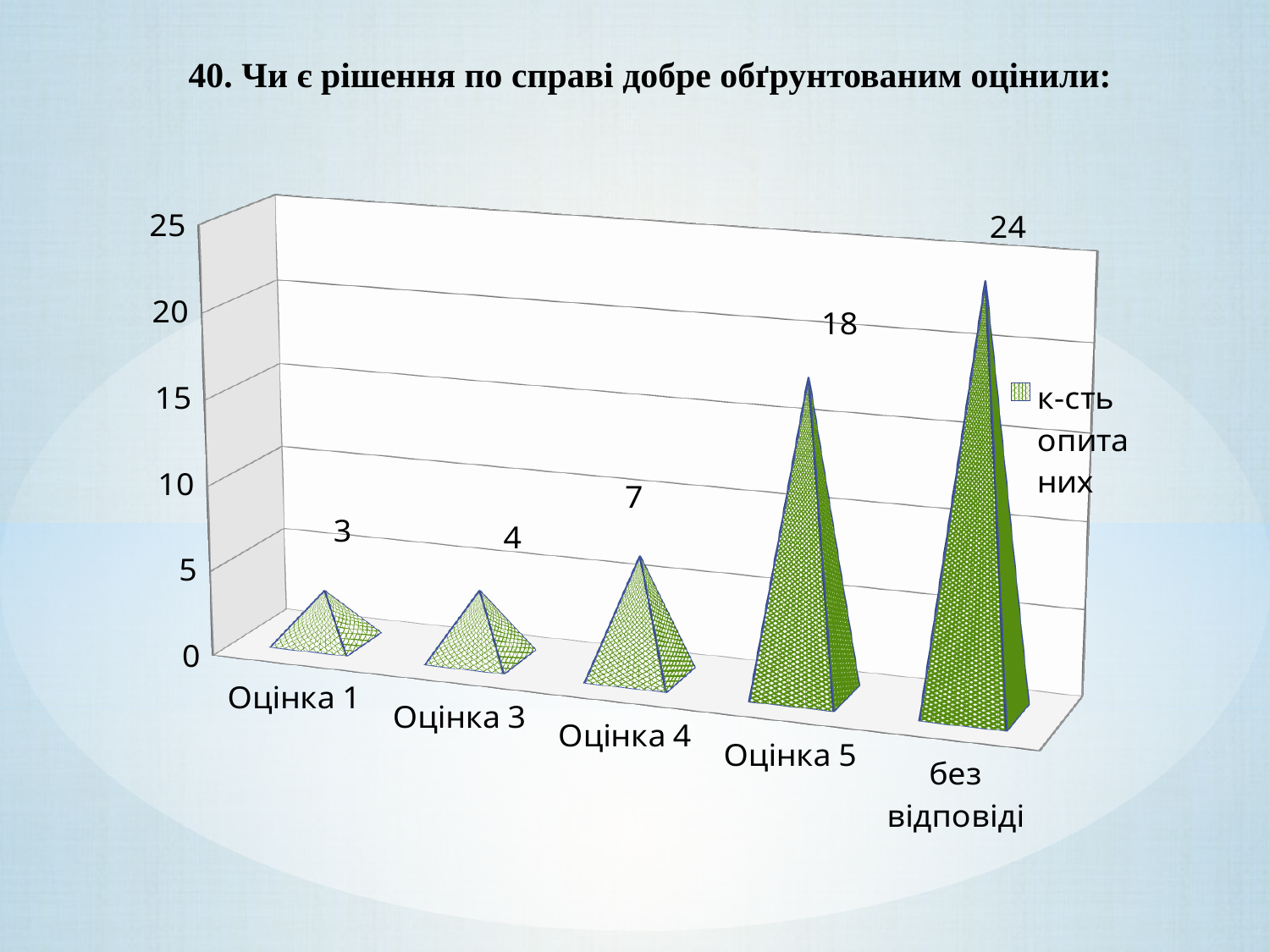
What is the difference between the values for без відповіді and Оцінка 5? 6 Which category has the lowest value? Оцінка 1 What is the value for Оцінка 5? 18 Which is larger, the value for Оцінка 3 or the value for Оцінка 4? Оцінка 4 What is the value for без відповіді? 24 What is the value for Оцінка 4? 7 What is the value for Оцінка 1? 3 How many categories are shown on the x axis? 5 What kind of chart is shown on the slide? bar chart Which category has the highest value? без відповіді How many series does the legend list? 1 What is the legend entry for the series? к-сть опитаних